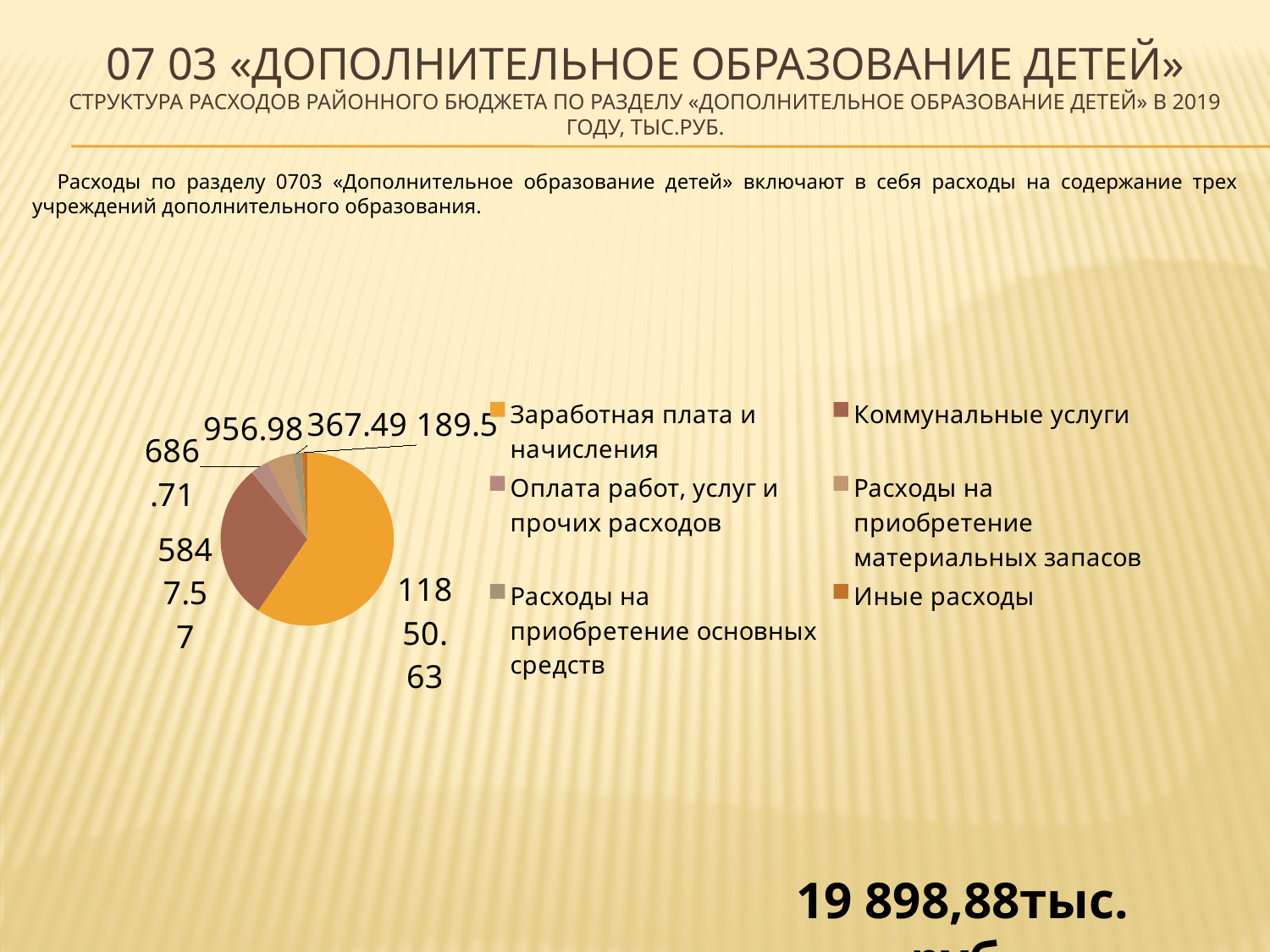
What is the value of the smallest slice in the pie chart? 189.5 What is the difference between the slice values 956.98 and 367.49? 589.49 What is the value of the largest slice in the pie chart? 11850.63 Which is larger, the slice labelled 367.49 or the slice labelled 189.5? 367.49 How many categories does the legend of the pie chart list? 6 What is the value shown for Заработная плата и начисления? 11850.63 Which is larger, the slice labelled 956.98 or the slice labelled 686.71? 956.98 What is the difference between the two largest slice values, 11850.63 and 5847.57? 6003.06 Which category has the largest slice in the pie chart? Заработная плата и начисления What total amount in thousand rubles is printed in bold at the bottom right of the slide? 19 898,88 тыс. руб. Which legend entry is shown in orange in the pie chart? Заработная плата и начисления What type of chart is shown on the slide? pie chart